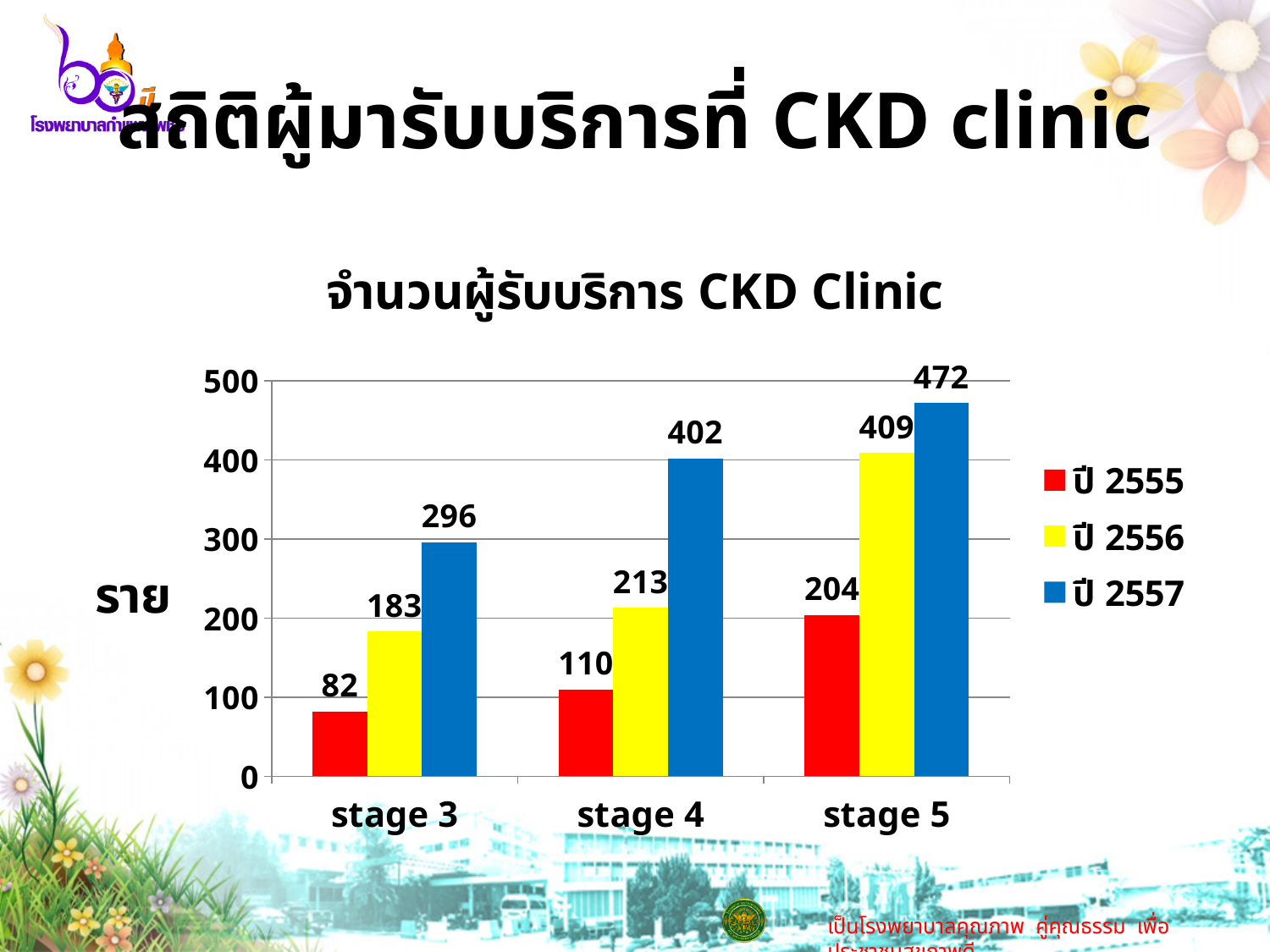
How many series does the legend list? 3 How many stage categories are shown on the x axis? 3 What is the value for stage 5 in the ปี 2555 series? 204 What is the value for stage 3 in the ปี 2557 series? 296 Which stage has the highest value in the ปี 2557 series? stage 5 Which stage has the lowest value in the ปี 2555 series? stage 3 Which is larger: the ปี 2556 value for stage 5 or the ปี 2557 value for stage 4? ปี 2556 value for stage 5 What kind of chart is shown? bar chart Is the ปี 2557 value for stage 5 greater or less than 400? greater What is the difference between the ปี 2557 and ปี 2556 values for stage 4? 189 Do the ปี 2557 values rise or fall from stage 3 to stage 5? rise What is the value for stage 4 in the ปี 2556 series? 213